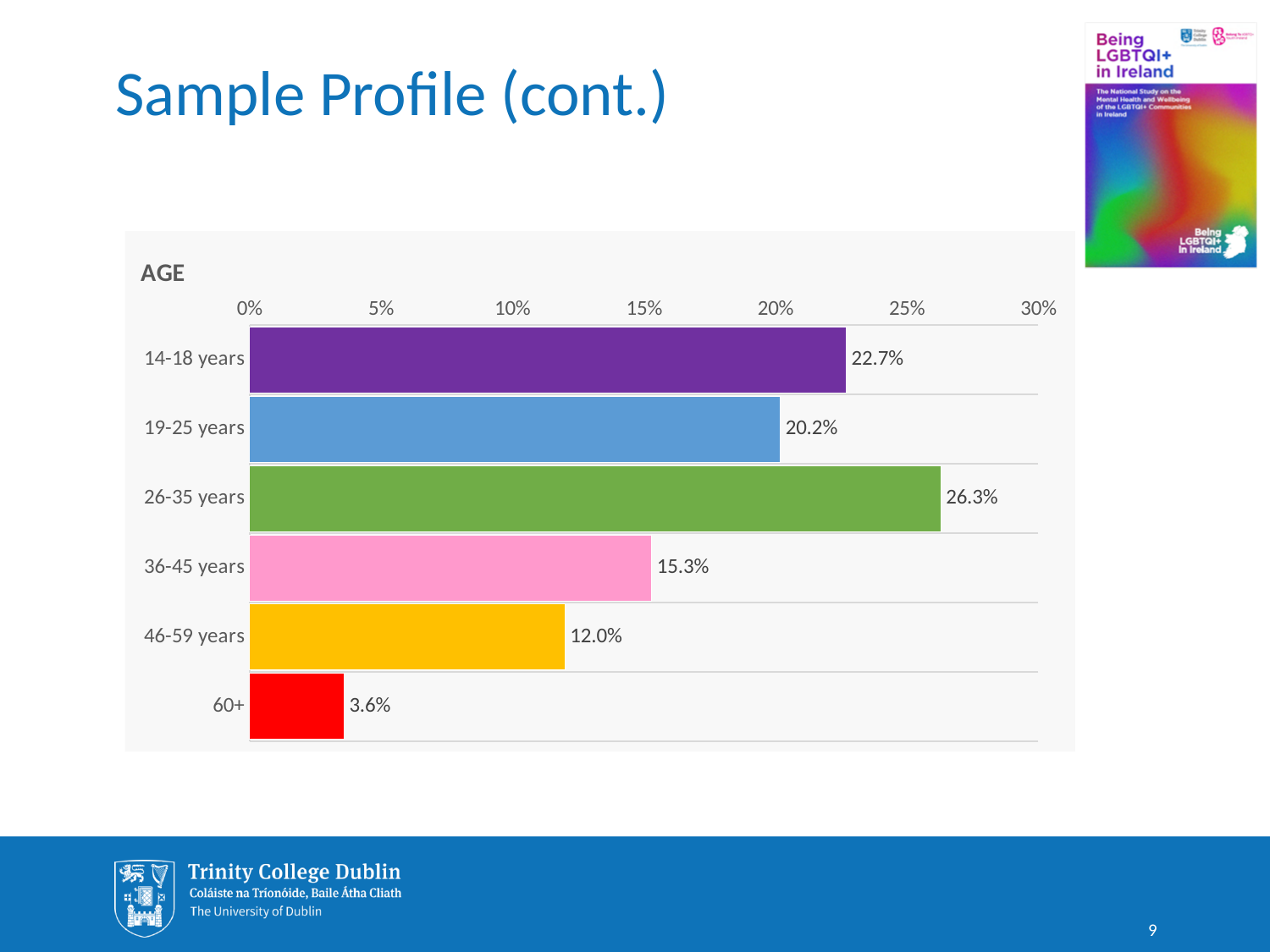
Which is larger, the value for 14-18 years or the value for 36-45 years? 14-18 years What is the value for 14-18 years? 22.7% What is the value for 60+? 3.6% What is the title of the chart? AGE What is the difference between the values for 26-35 years and 19-25 years? 6.1% Which age group has the lowest value? 60+ Which age group has the highest value? 26-35 years What is the value for 46-59 years? 12.0% What kind of chart is shown on the slide? Bar chart How many age categories are shown in the chart? 6 Is the value for 19-25 years greater or less than 15%? greater What colour is the bar for 60+? Red